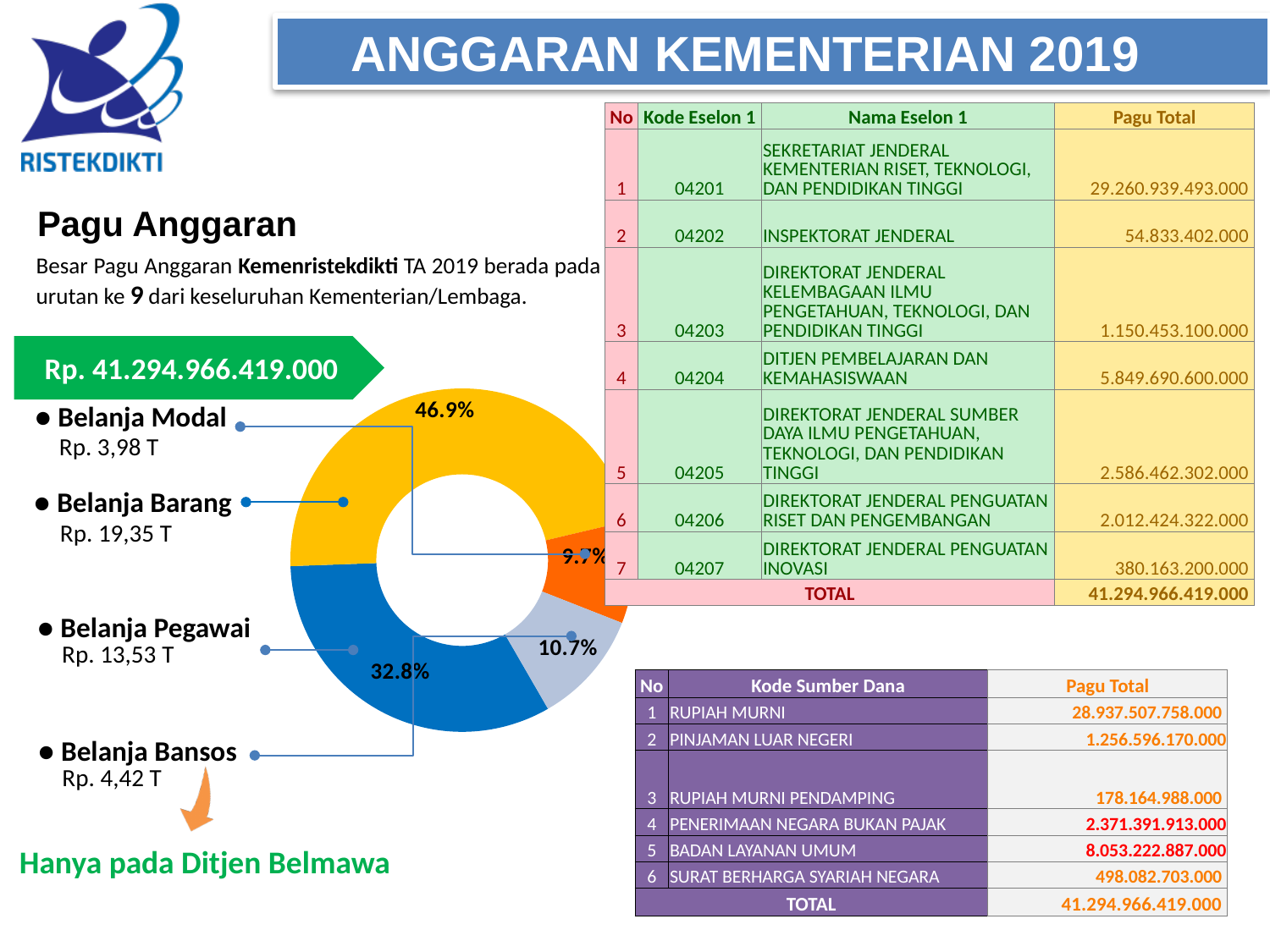
What percentage share does Belanja Bansos have in the doughnut chart? 10.7% Which slice is larger, Belanja Pegawai or Belanja Bansos? Belanja Pegawai What percentage share does Belanja Barang have in the doughnut chart? 46.9% What kind of chart is shown on the slide? Doughnut (pie) chart What is the difference in percentage points between the Belanja Barang and Belanja Pegawai slices? 14.1 percentage points What rupiah amount is listed for Belanja Pegawai next to the doughnut chart? Rp. 13,53 T What percentage share does Belanja Pegawai have in the doughnut chart? 32.8% What colour is the Belanja Pegawai slice in the doughnut chart? Blue How many categories are shown in the doughnut chart? 4 What rupiah amount is listed for Belanja Barang next to the doughnut chart? Rp. 19,35 T Which category has the smallest slice in the doughnut chart? Belanja Modal Which category has the largest slice in the doughnut chart? Belanja Barang